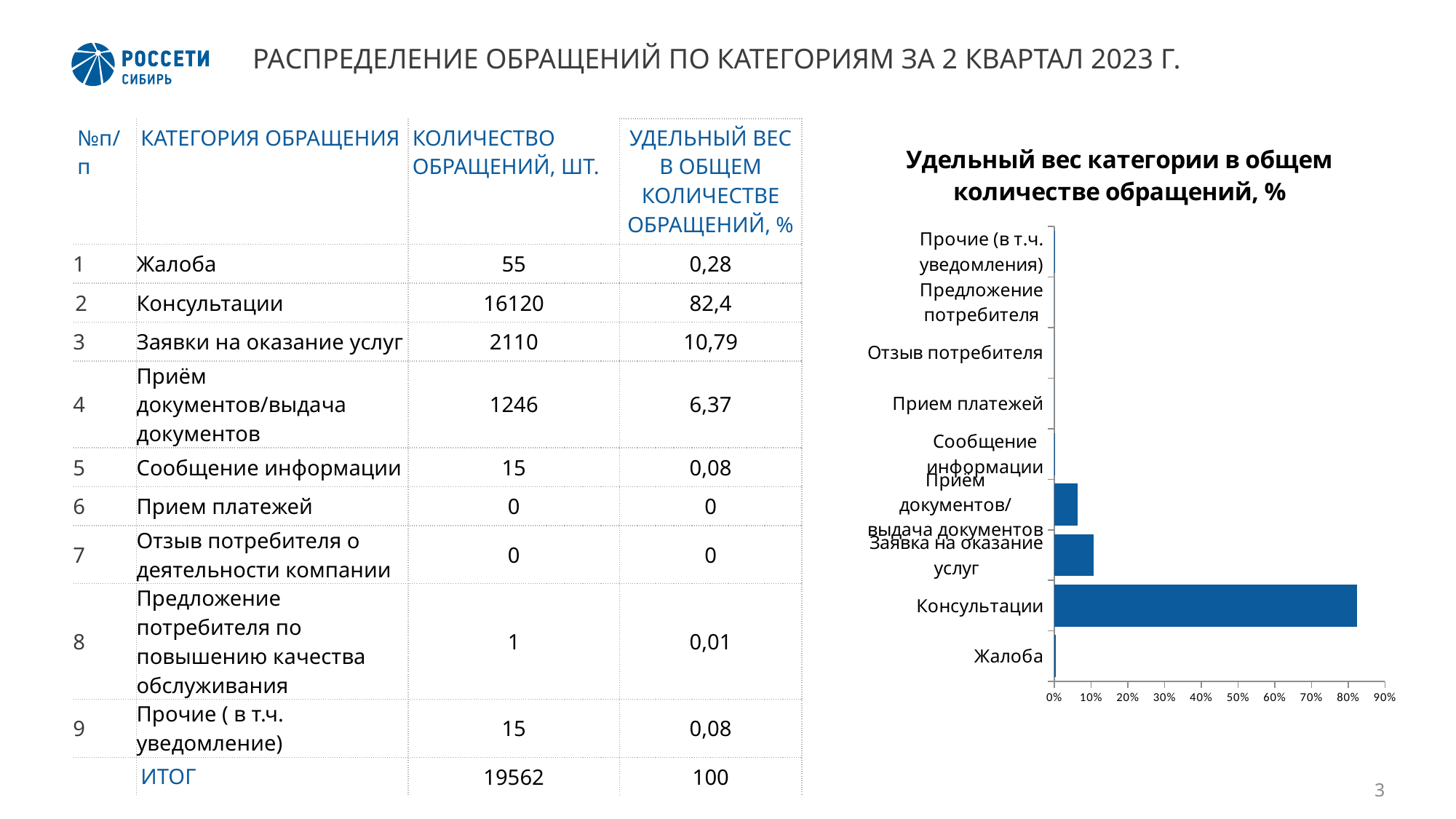
How many categories are plotted in the chart "Удельный вес категории в общем количестве обращений, %"? 9 In the chart, is the value for Приём документов/выдача документов greater or less than 10%? less What type of chart is shown on the right side of the slide? bar chart In the chart, is the value for Консультации greater or less than 70%? greater According to the slide, what is the difference between the share of Консультации (82,4) and the share of Заявки на оказание услуг (10,79)? 71,61 In the chart, is the value for Заявка на оказание услуг greater or less than 20%? less According to the slide, what is the share (удельный вес) of Консультации in the total number of обращений? 82,4 Which category has the highest value in the chart "Удельный вес категории в общем количестве обращений, %"? Консультации What is the title of the chart on the slide? Удельный вес категории в общем количестве обращений, % What is the highest tick value shown on the horizontal axis of the chart? 90% In the chart, which is larger: the value for Консультации or the value for Жалоба? Консультации In the chart, which is larger: the value for Заявка на оказание услуг or the value for Приём документов/выдача документов? Заявка на оказание услуг